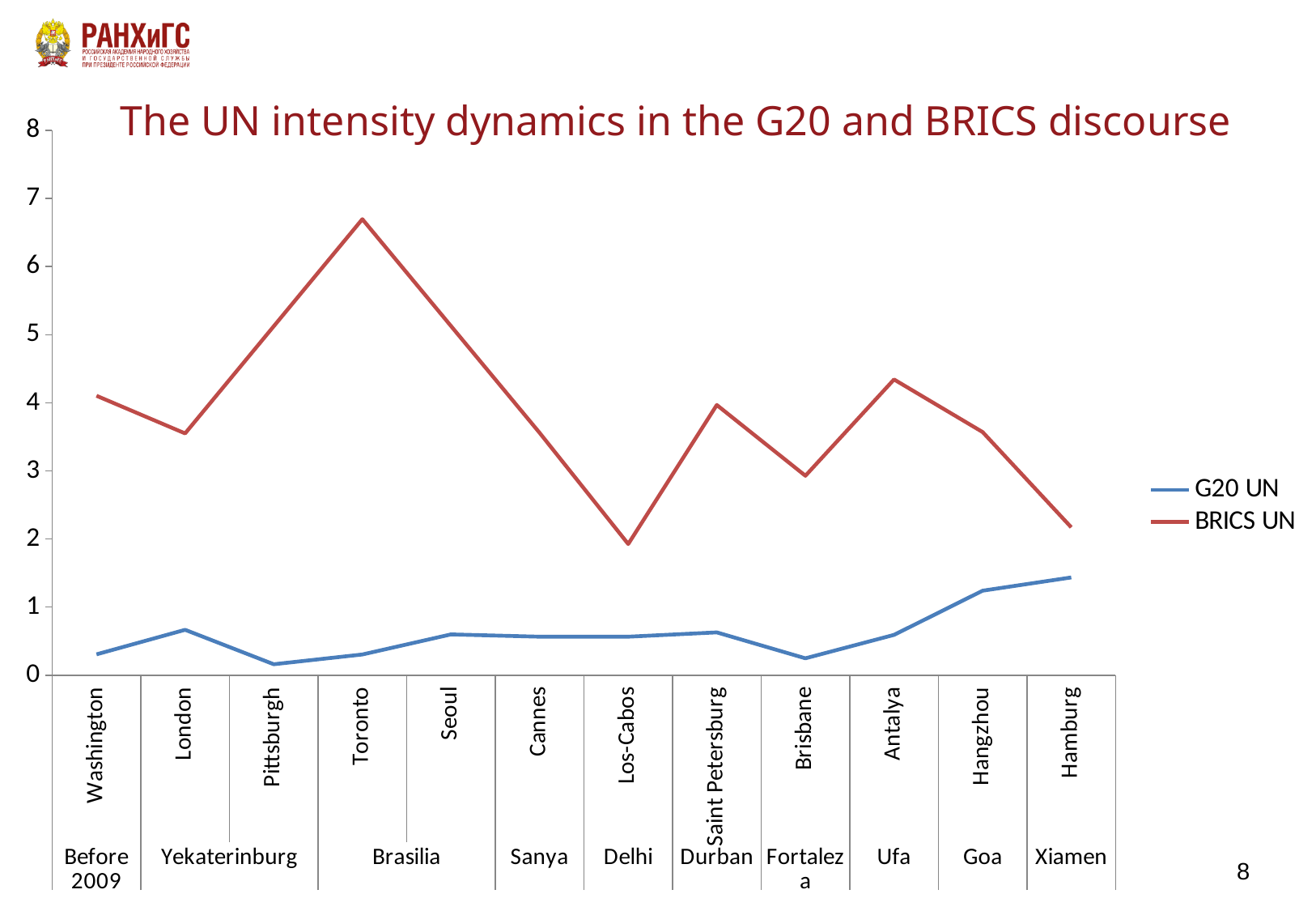
Is the G20 UN value at Hamburg greater or less than 1? greater Which series has the higher value at Washington, G20 UN or BRICS UN? BRICS UN Is the BRICS UN value at Toronto greater or less than 6? greater Is the BRICS UN value at Los-Cabos greater or less than 2? less At which summit does the BRICS UN series reach its highest value? Toronto What is the title of the chart? The UN intensity dynamics in the G20 and BRICS discourse How many series does the legend list? 2 At which summit does the G20 UN series reach its highest value? Hamburg What kind of chart is shown on the slide? line chart Does the G20 UN series rise or fall from Antalya to Hamburg? rise At which summit does the BRICS UN series reach its lowest value? Los-Cabos How many summit points are plotted along the x axis? 12